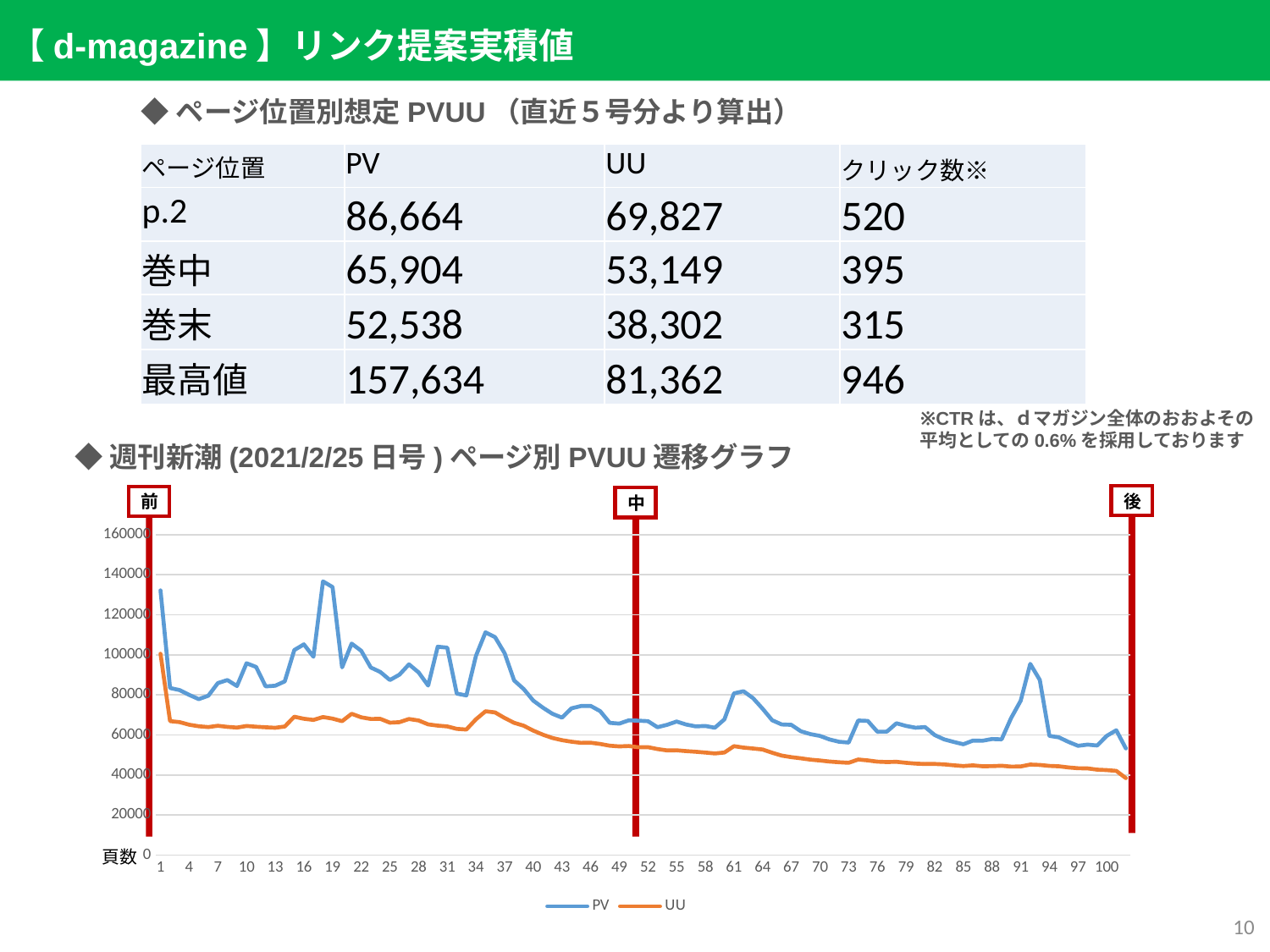
Is the UU value at page 52 greater or less than 60000? less How many series does the chart legend list? 2 At page 1, which series has the larger value, PV or UU? PV Overall, does the PV line rise or fall as the page number increases along the x axis? fall Overall, does the UU line rise or fall from page 1 to page 100? fall Is the UU value at page 52 greater or less than 40000? greater Is the PV value at page 52 greater or less than 80000? less What kind of chart is shown on the slide? line chart What are the two series named in the chart legend? PV and UU Which colour is used for the UU line in the chart? orange